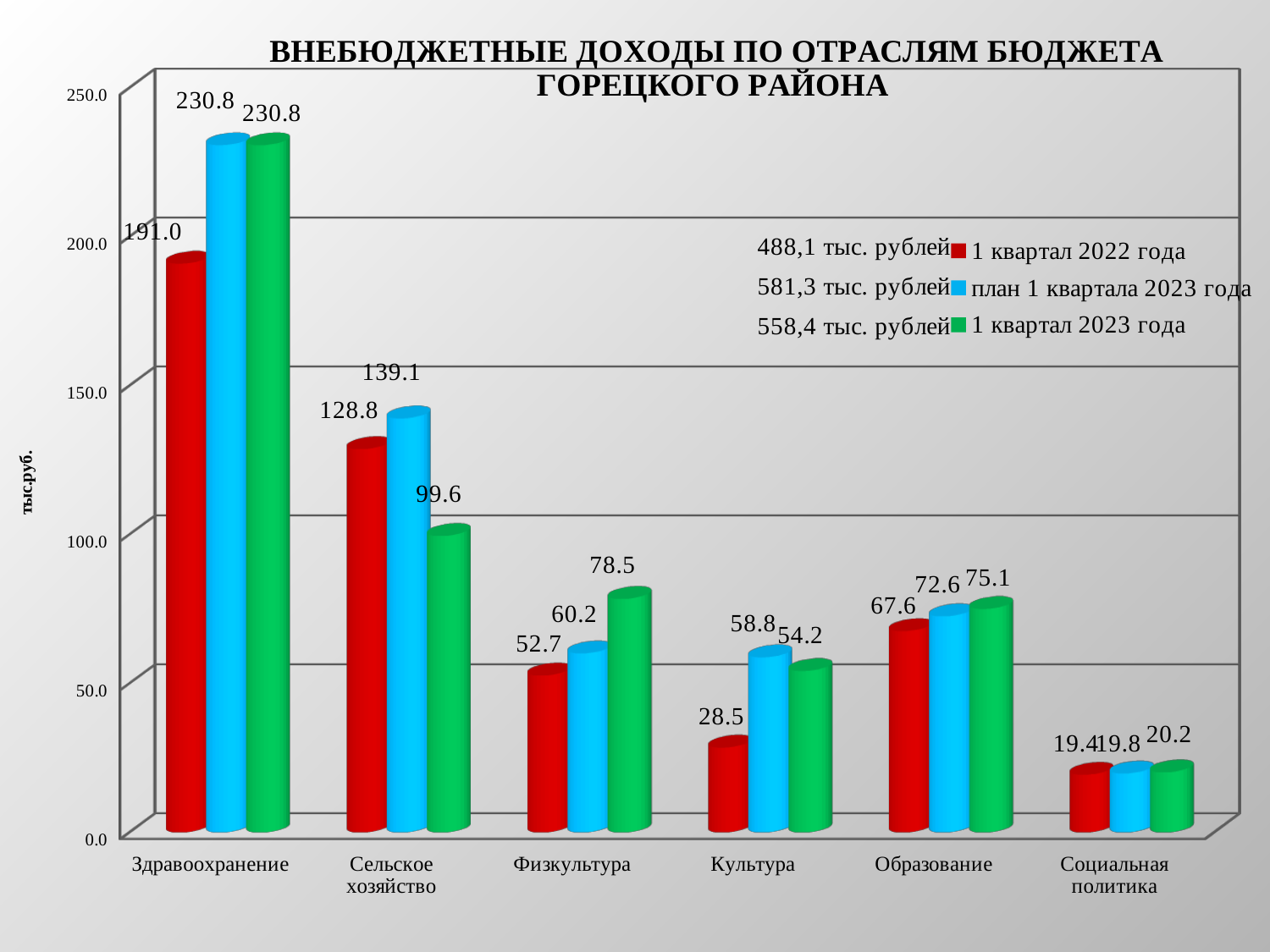
What is the difference between the 'план 1 квартала 2023 года' and '1 квартал 2022 года' values for Здравоохранение? 39.8 Is the value for Сельское хозяйство in the series '1 квартал 2022 года' greater or less than 100.0? greater How many series does the legend list? 3 For Физкультура, which is larger: the value for '1 квартал 2023 года' or for '1 квартал 2022 года'? 1 квартал 2023 года What kind of chart is shown on the slide? bar chart How many categories are shown on the x axis? 6 What is the value for Культура in the series 'план 1 квартала 2023 года'? 58.8 What is the value for Сельское хозяйство in the series '1 квартал 2023 года'? 99.6 Which category has the highest value in the series '1 квартал 2023 года'? Здравоохранение What total is shown in the legend next to 'план 1 квартала 2023 года'? 581,3 тыс. рублей What is the value for Здравоохранение in the series '1 квартал 2022 года'? 191.0 Which category has the lowest value in the series '1 квартал 2022 года'? Социальная политика